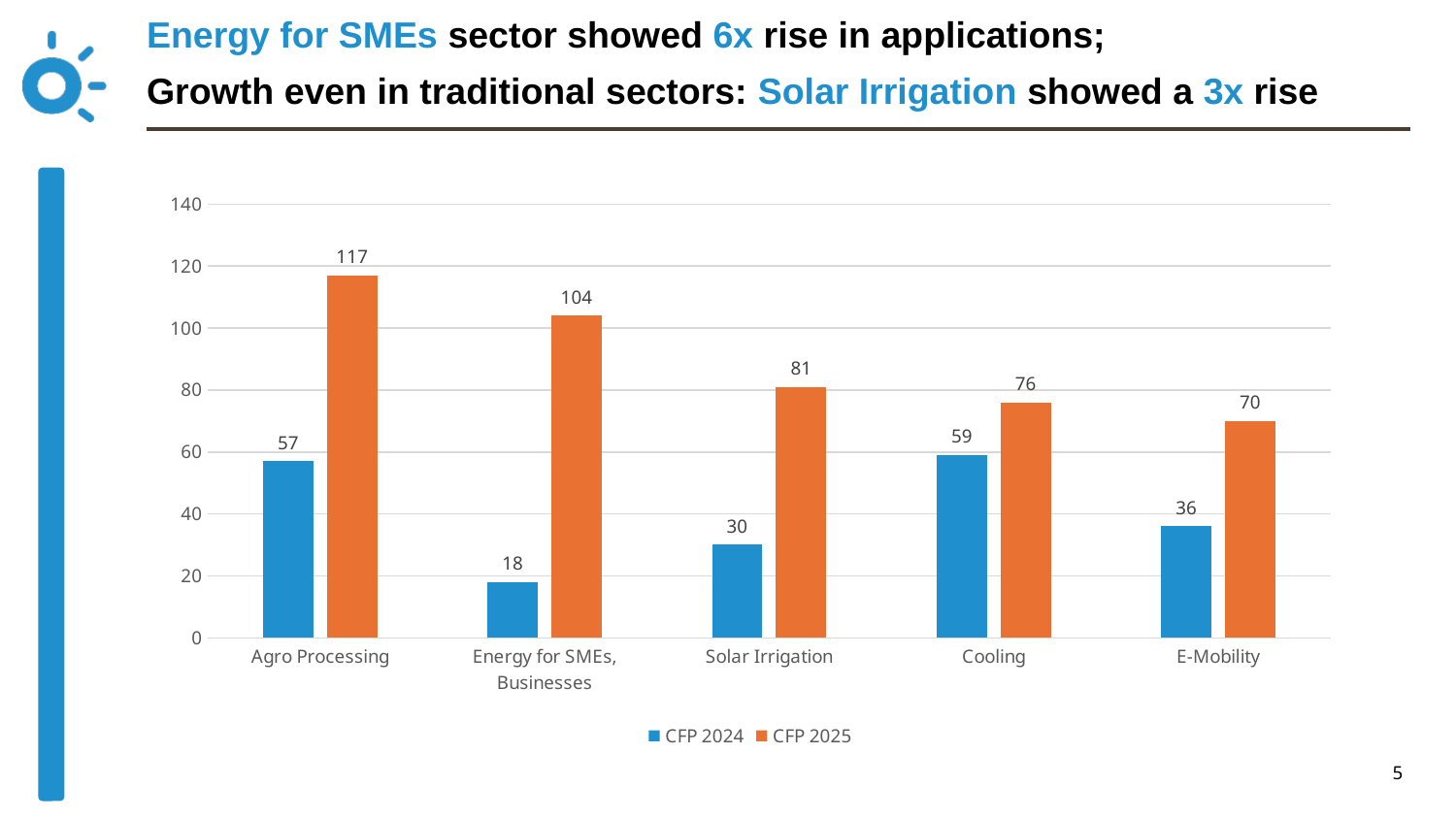
Which is larger: the CFP 2024 value for Cooling or the CFP 2024 value for Agro Processing? Cooling What colour are the CFP 2025 bars? Orange What is the CFP 2024 value for Energy for SMEs, Businesses? 18 What kind of chart is shown on the slide? Bar chart What is the difference between the CFP 2025 and CFP 2024 values for Cooling? 17 What is the CFP 2025 value for Solar Irrigation? 81 Is the CFP 2025 value for E-Mobility greater or less than 60? greater How many series does the legend list? 2 Which category has the highest CFP 2025 value? Agro Processing Which category has the lowest CFP 2024 value? Energy for SMEs, Businesses How many categories are shown on the x axis? 5 What is the CFP 2025 value for Agro Processing? 117